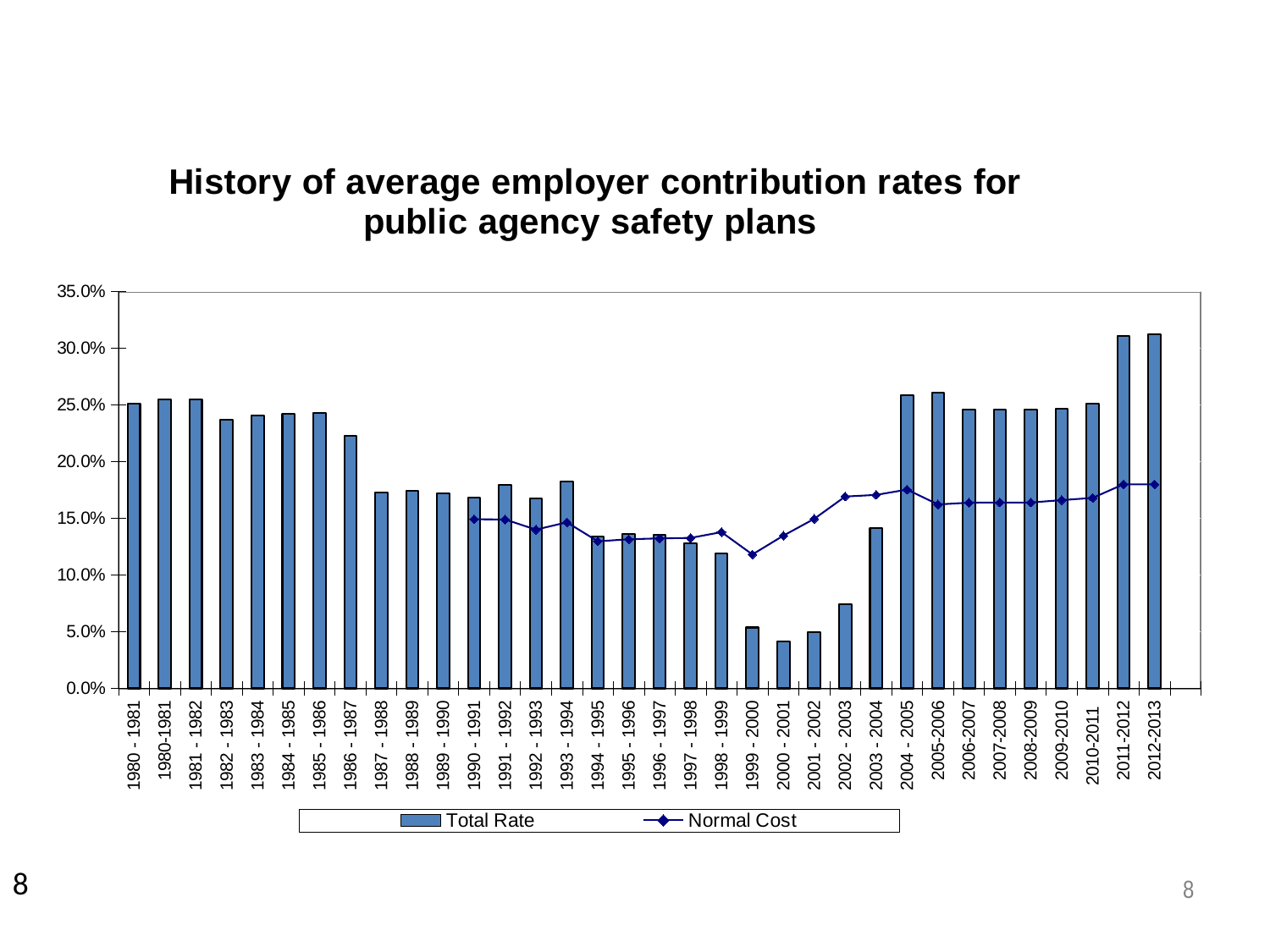
Is the Total Rate for 1986 - 1987 greater or less than 20.0%? greater What kind of chart is shown on the slide? A bar chart combined with a line chart Is the Total Rate for 2011-2012 greater or less than 30.0%? greater Which is larger, the Total Rate for 2003 - 2004 or for 2004 - 2005? 2004 - 2005 Does the Normal Cost rise or fall from 1999 - 2000 to 2004 - 2005? rise How many series does the legend list? 2 What are the two series named in the legend? Total Rate and Normal Cost Which year has the lowest Total Rate? 2000 - 2001 Is the Normal Cost for 2004 - 2005 greater or less than 20.0%? less What is the title of the chart? History of average employer contribution rates for public agency safety plans Which is larger in 2001 - 2002, the Total Rate or the Normal Cost? Normal Cost